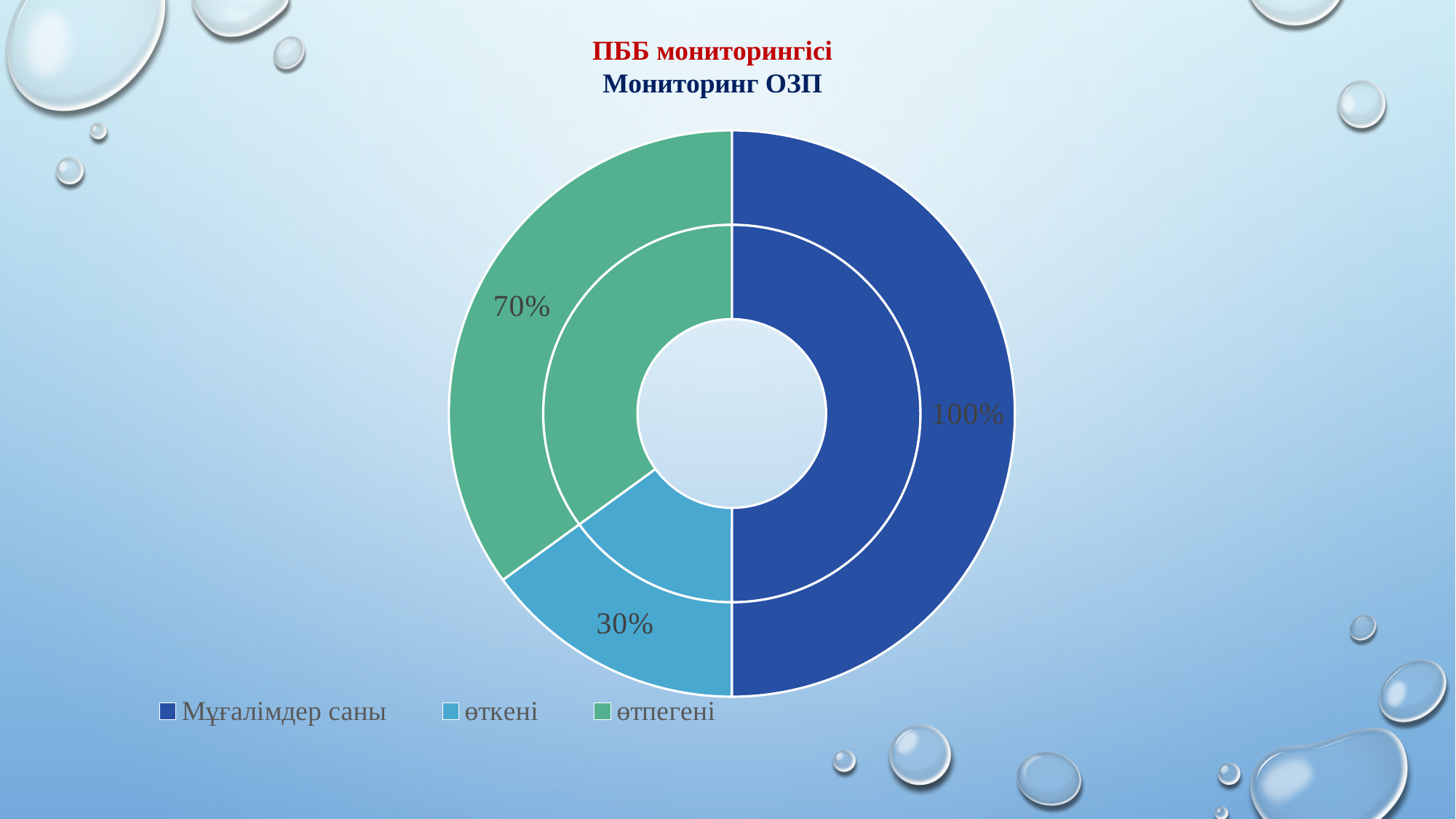
Which is larger, the өткені segment or the өтпегені segment? өтпегені Which legend entry has the smallest labelled value? өткені How many rings does the doughnut chart have? 2 What colour is the өтпегені segment? green Which legend entry has the largest labelled value? Мұғалімдер саны What percentage is labelled on the өтпегені segment? 70% What percentage is labelled on the өткені segment? 30% What percentage is labelled on the Мұғалімдер саны segment? 100% What is the difference between the өтпегені value and the өткені value? 40% How many entries does the legend list? 3 What is the title of the chart? ПББ мониторингісі Мониторинг ОЗП What kind of chart is shown on the slide? doughnut chart